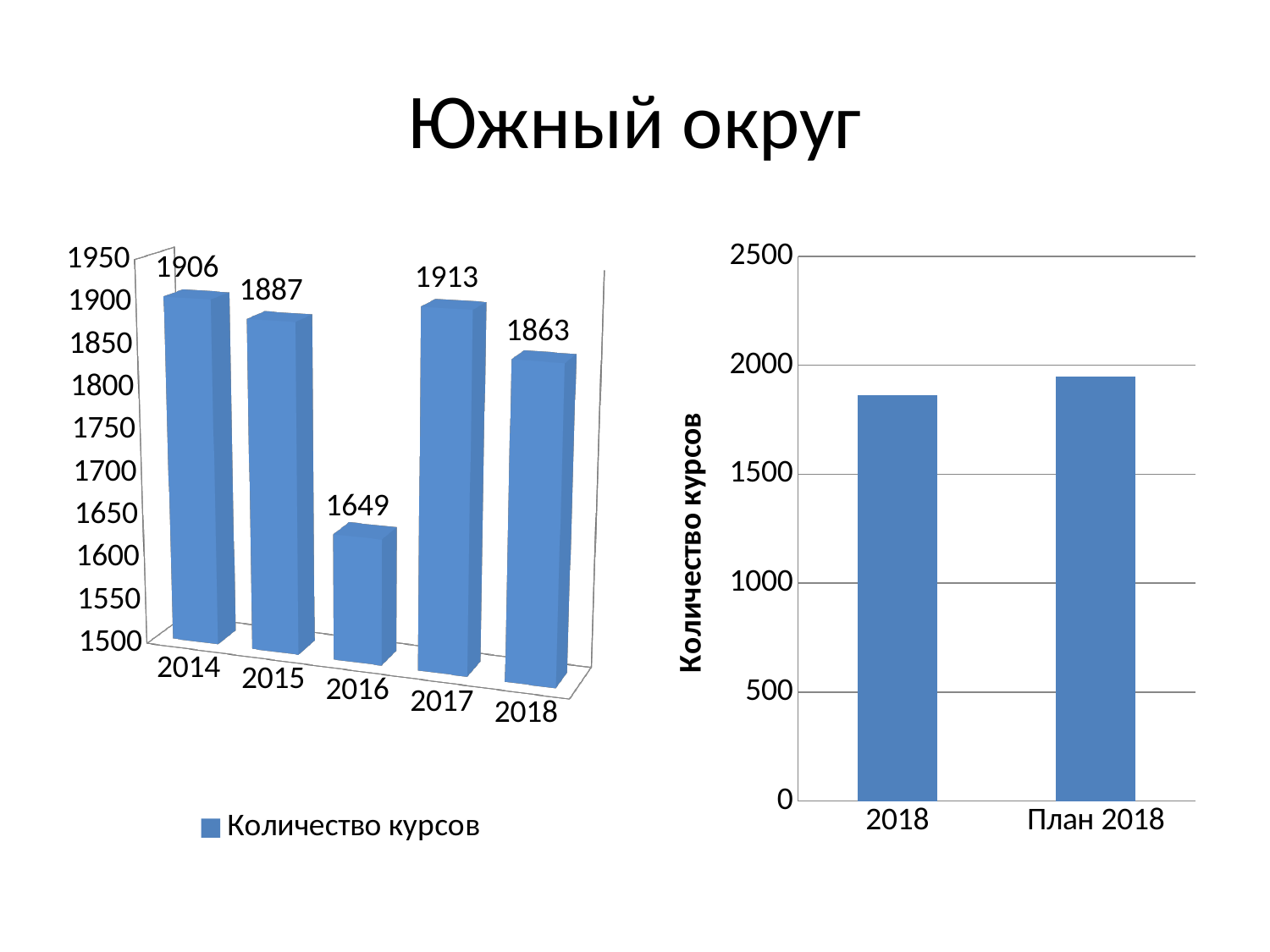
In the right chart, is the value for План 2018 greater or less than 2000? less What kind of chart is the left chart? bar chart In the left chart, what is the difference between the values for 2017 and 2016? 264 How many years are shown in the left chart? 5 In the left chart, which is larger, the value for 2015 or the value for 2018? 2015 In the left chart, which year has the highest value? 2017 In the right chart, is the value for 2018 greater or less than 1500? greater In the left chart, what is the value for 2018? 1863 In the left chart, what is the value for 2014? 1906 What is the y-axis title of the right chart? Количество курсов In the left chart, what is the value for 2016? 1649 In the left chart, which year has the lowest value? 2016